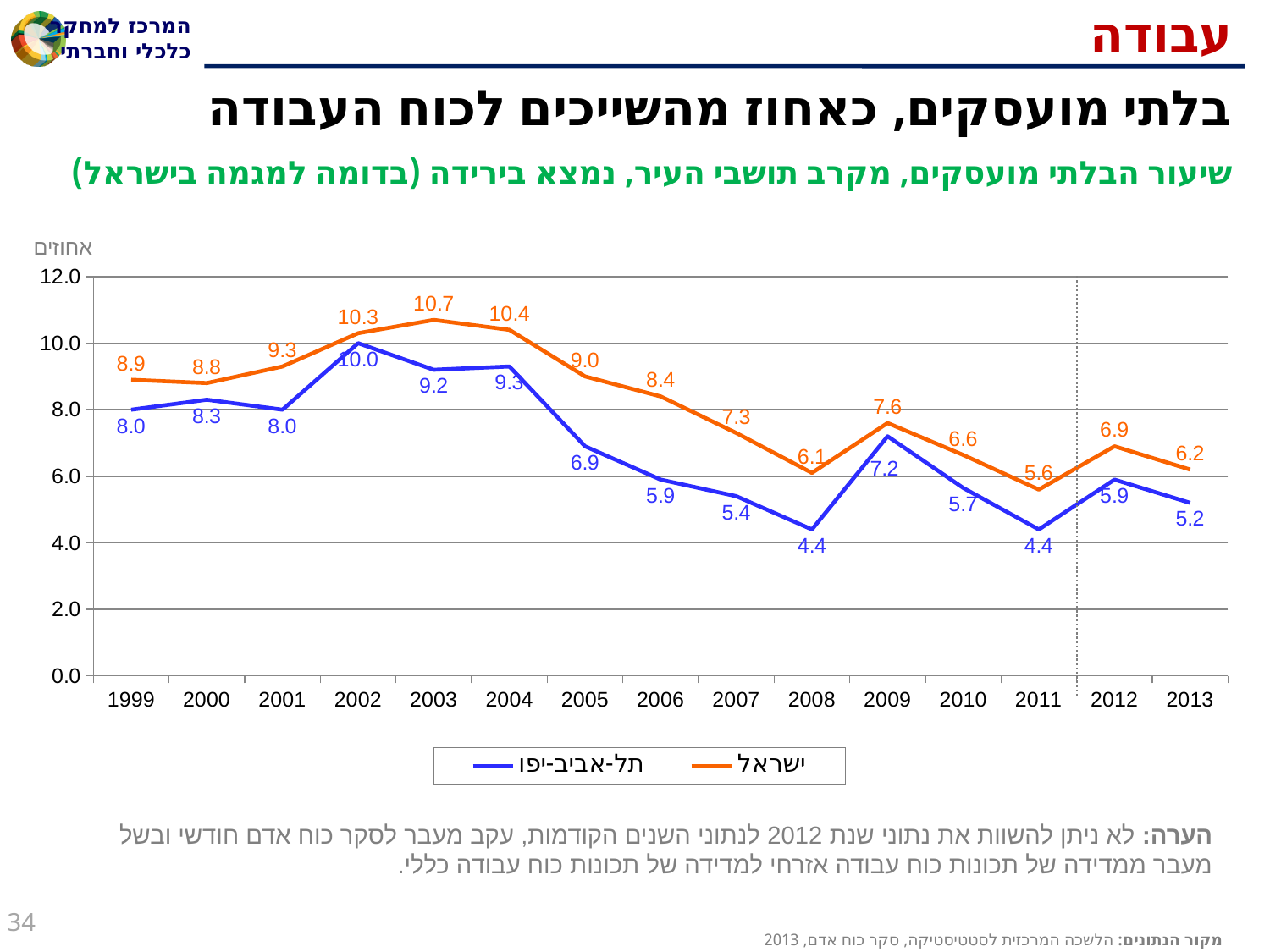
What is the lowest value of the ישראל series? 5.6 What is the value for תל-אביב-יפו in 2008? 4.4 How many series does the legend list? 2 What is the value for תל-אביב-יפו in 2013? 5.2 Overall, do the values for תל-אביב-יפו rise or fall from 2004 to 2008? fall In which year does the ישראל series reach its highest value? 2003 Which series has the higher value in 2002, ישראל or תל-אביב-יפו? ישראל What type of chart is shown on the slide? line chart What is the difference between the ישראל and תל-אביב-יפו values in 2011? 1.2 What is the value for ישראל in 2003? 10.7 How many years are shown on the x axis? 15 Is the value for תל-אביב-יפו in 2009 greater or less than 6.0? greater